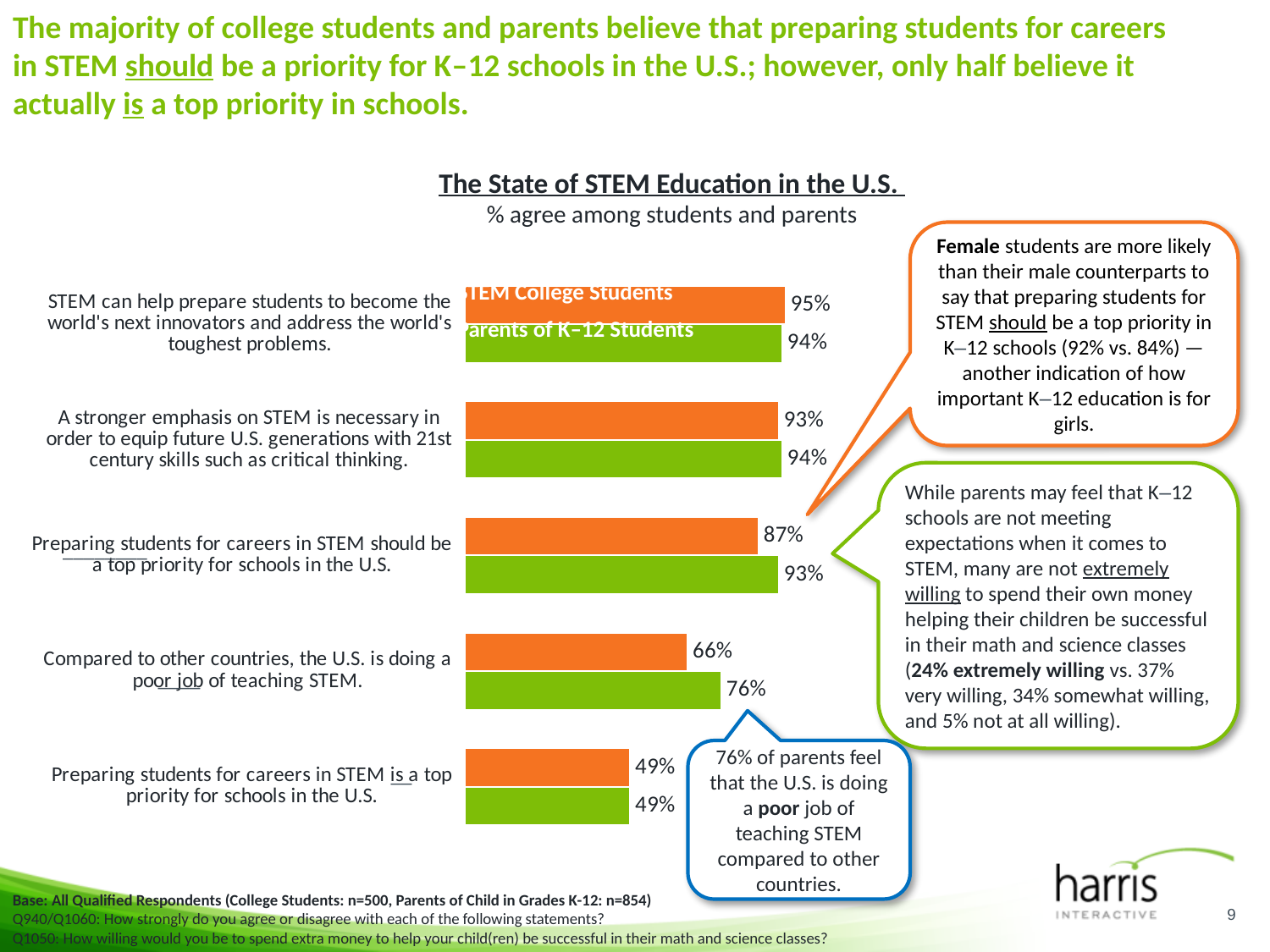
What percentage of parents of K-12 students agree that preparing students for careers in STEM is a top priority for schools in the U.S.? 49% Which statement has the lowest agreement among STEM college students? Preparing students for careers in STEM is a top priority for schools in the U.S. Which statement has the highest agreement among STEM college students? STEM can help prepare students to become the world's next innovators and address the world's toughest problems. What percentage of STEM college students agree that preparing students for careers in STEM should be a top priority for schools in the U.S.? 87% What kind of chart is shown under the title "The State of STEM Education in the U.S."? Bar chart How many series does the chart's legend list? 2 How many statements are plotted in the chart? 5 What percentage of STEM college students agree that STEM can help prepare students to become the world's next innovators? 95% What percentage of parents of K-12 students agree that, compared to other countries, the U.S. is doing a poor job of teaching STEM? 76% What is the subtitle shown beneath the chart title "The State of STEM Education in the U.S."? % agree among students and parents For the statement that preparing students for careers in STEM should be a top priority, which group shows higher agreement: STEM college students or parents of K-12 students? Parents of K-12 students What is the difference between parents and STEM college students in agreement that the U.S. is doing a poor job of teaching STEM compared to other countries? 10 percentage points